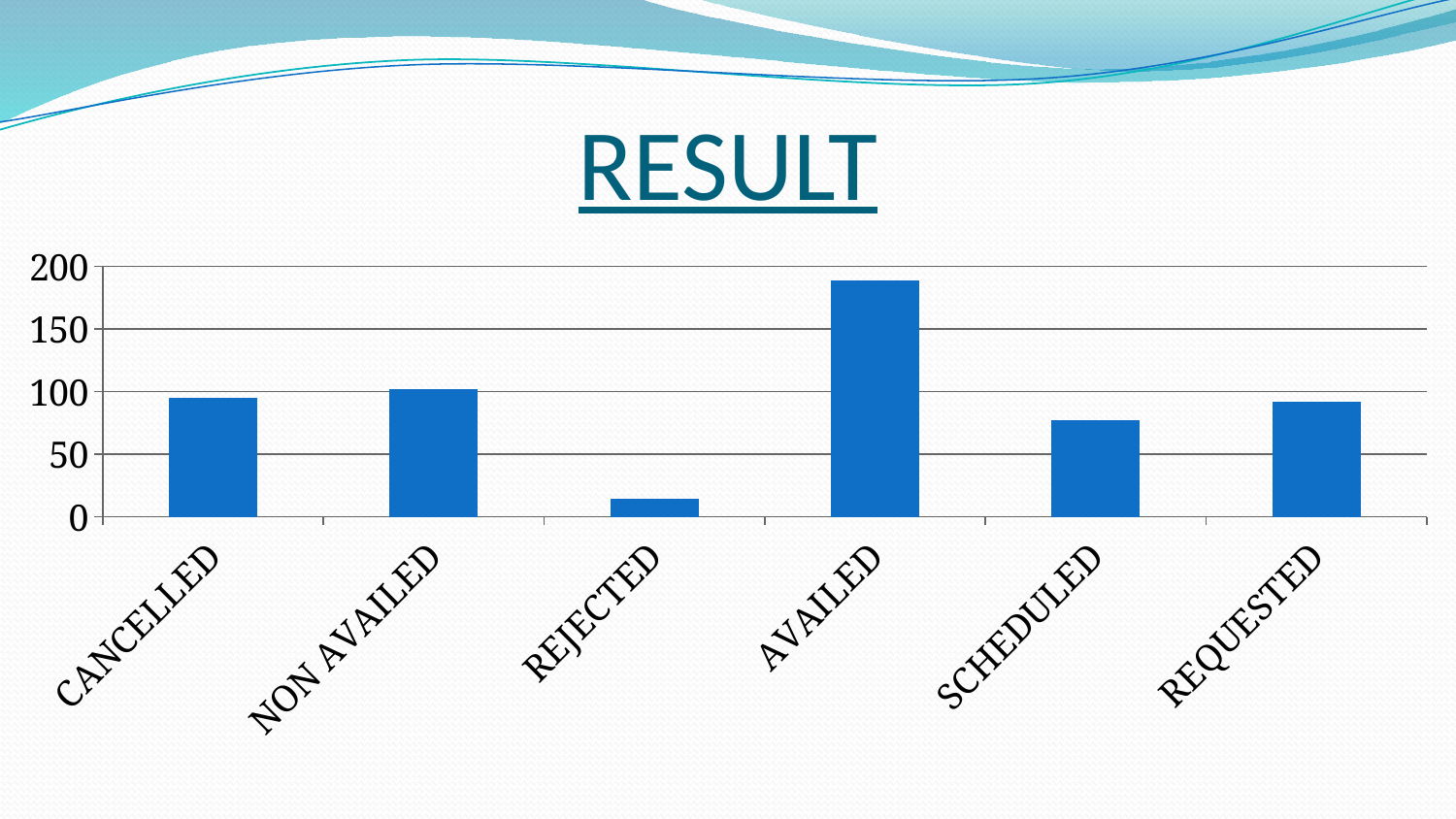
How many categories are shown on the x axis of the chart? 6 Is the value for SCHEDULED greater or less than 50? greater Is the value for REJECTED greater or less than 50? less What kind of chart is shown on the slide? bar chart Is the value for AVAILED greater or less than 150? greater What is the title of the slide containing the chart? RESULT Which is larger, the value for AVAILED or the value for SCHEDULED? AVAILED Which category has the lowest bar? REJECTED Which category has the highest bar? AVAILED Which is larger, the value for REJECTED or the value for SCHEDULED? SCHEDULED